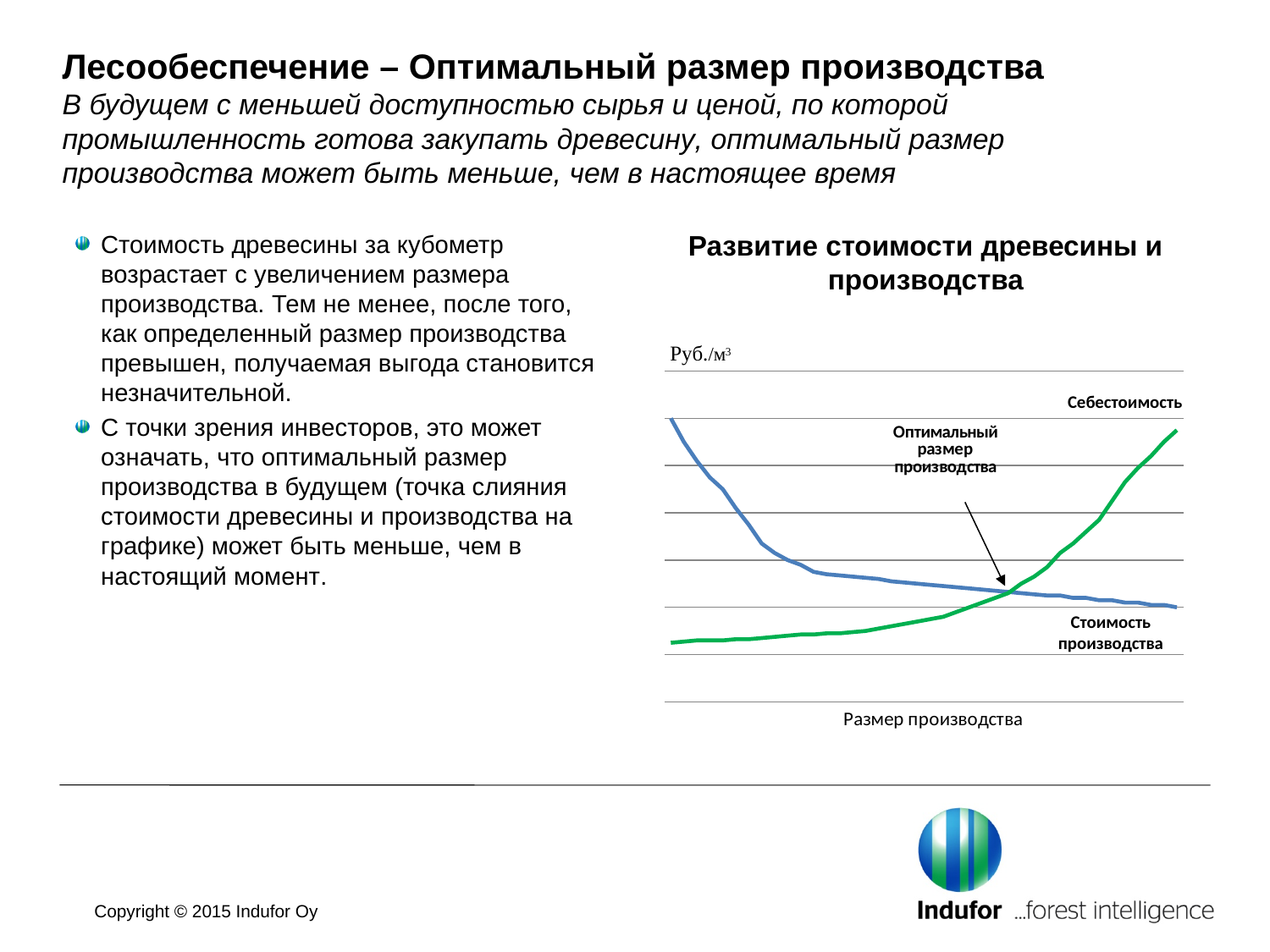
What kind of chart is shown on the slide? Line chart What unit is shown on the y axis of the chart? Руб./м³ Does the line labelled "Стоимость производства" rise or fall as the production size increases along the x axis? Falls How many lines are plotted on the chart? 2 What does the arrow on the chart point to, according to its label? Оптимальный размер производства Does the line labelled "Себестоимость" rise or fall as the production size increases along the x axis? Rises What is the label of the x axis of the chart? Размер производства Which line is higher at the left edge of the chart, "Себестоимость" or "Стоимость производства"? Стоимость производства Which line is higher at the right edge of the chart, "Себестоимость" or "Стоимость производства"? Себестоимость